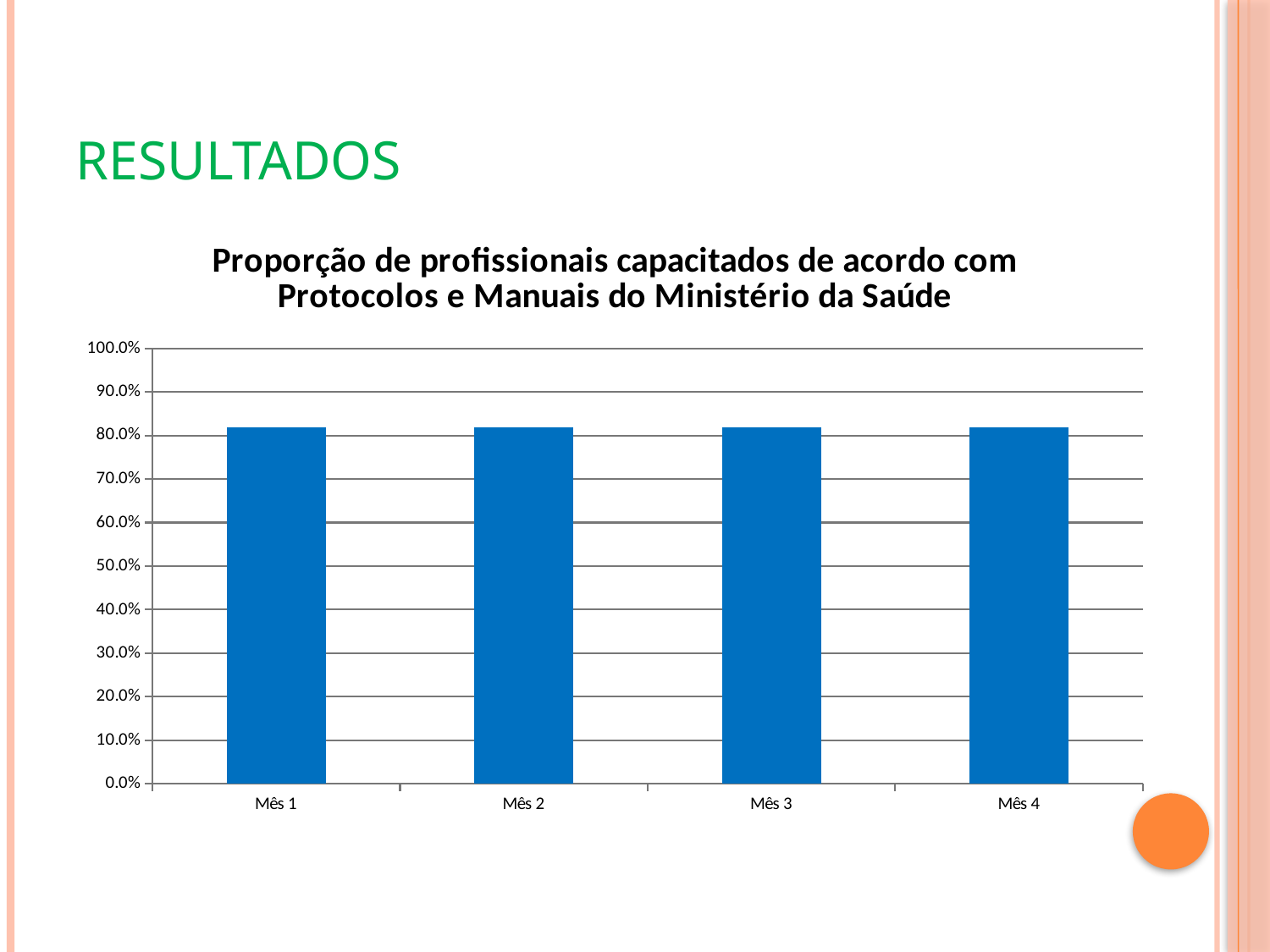
How many categories are shown on the x axis of the chart? 4 What is the highest value shown on the y axis of the chart? 100.0% Is the value for Mês 3 greater or less than 50.0%? greater Is the value for Mês 4 greater or less than 100.0%? less Is the value for Mês 2 greater or less than 90.0%? less What is the title of the chart? Proporção de profissionais capacitados de acordo com Protocolos e Manuais do Ministério da Saúde What kind of chart is shown on the slide? bar chart What is the label of the first category on the x axis? Mês 1 Do the values rise, fall, or stay roughly the same from Mês 1 to Mês 4? stay roughly the same